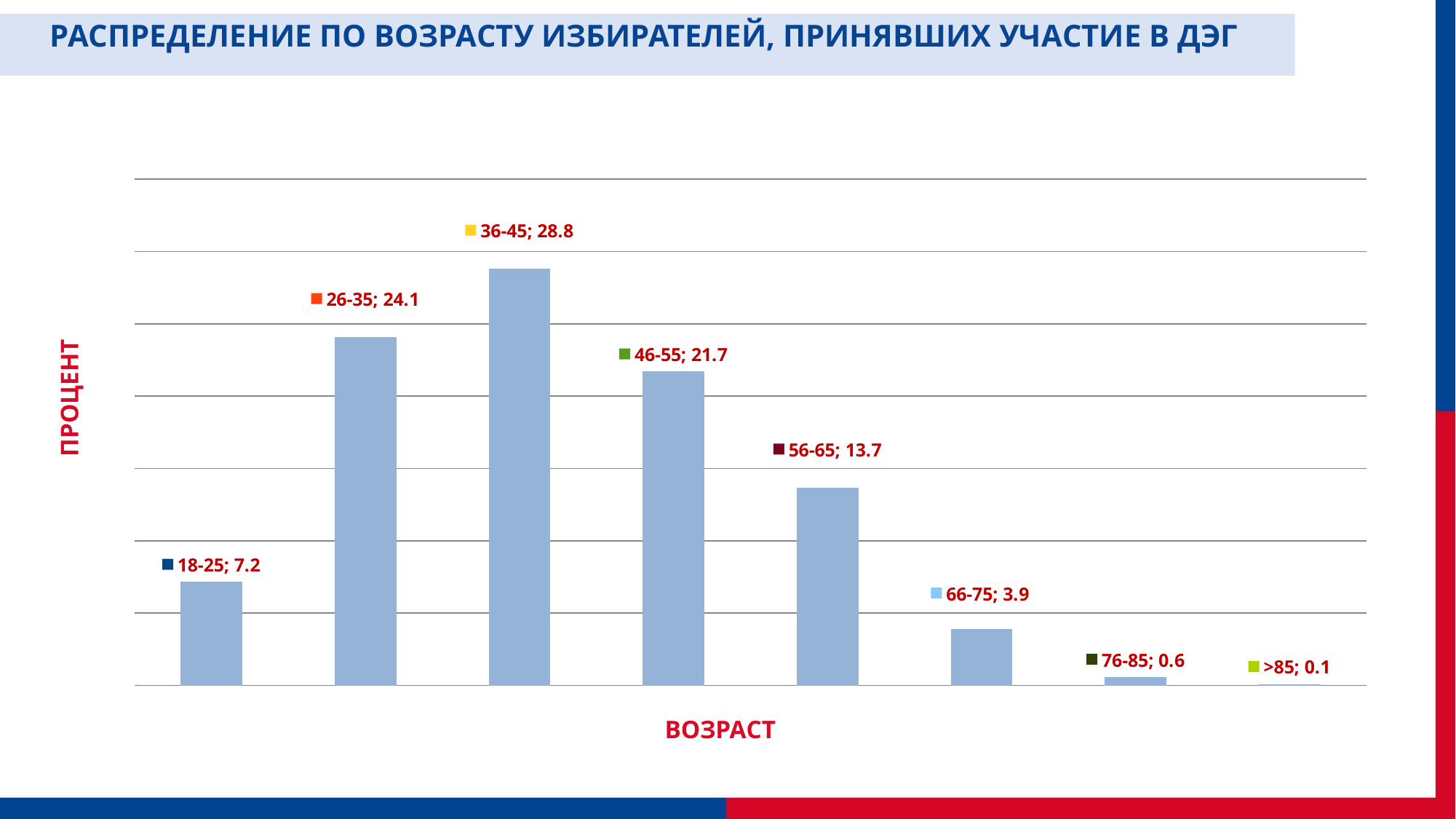
Which age group has the lowest value? >85 How many age groups are shown in the chart? 8 Which is larger, the value for 26-35 or the value for 46-55? 26-35 What is the label of the x axis? ВОЗРАСТ What is the difference between the values for 46-55 and 56-65? 8.0 What is the title of the chart? РАСПРЕДЕЛЕНИЕ ПО ВОЗРАСТУ ИЗБИРАТЕЛЕЙ, ПРИНЯВШИХ УЧАСТИЕ В ДЭГ Which age group has the highest value? 36-45 What kind of chart is shown on the slide? bar chart What is the value for the 66-75 age group? 3.9 What is the value for the 36-45 age group? 28.8 What is the value for the 18-25 age group? 7.2 What is the difference between the values for 36-45 and 26-35? 4.7